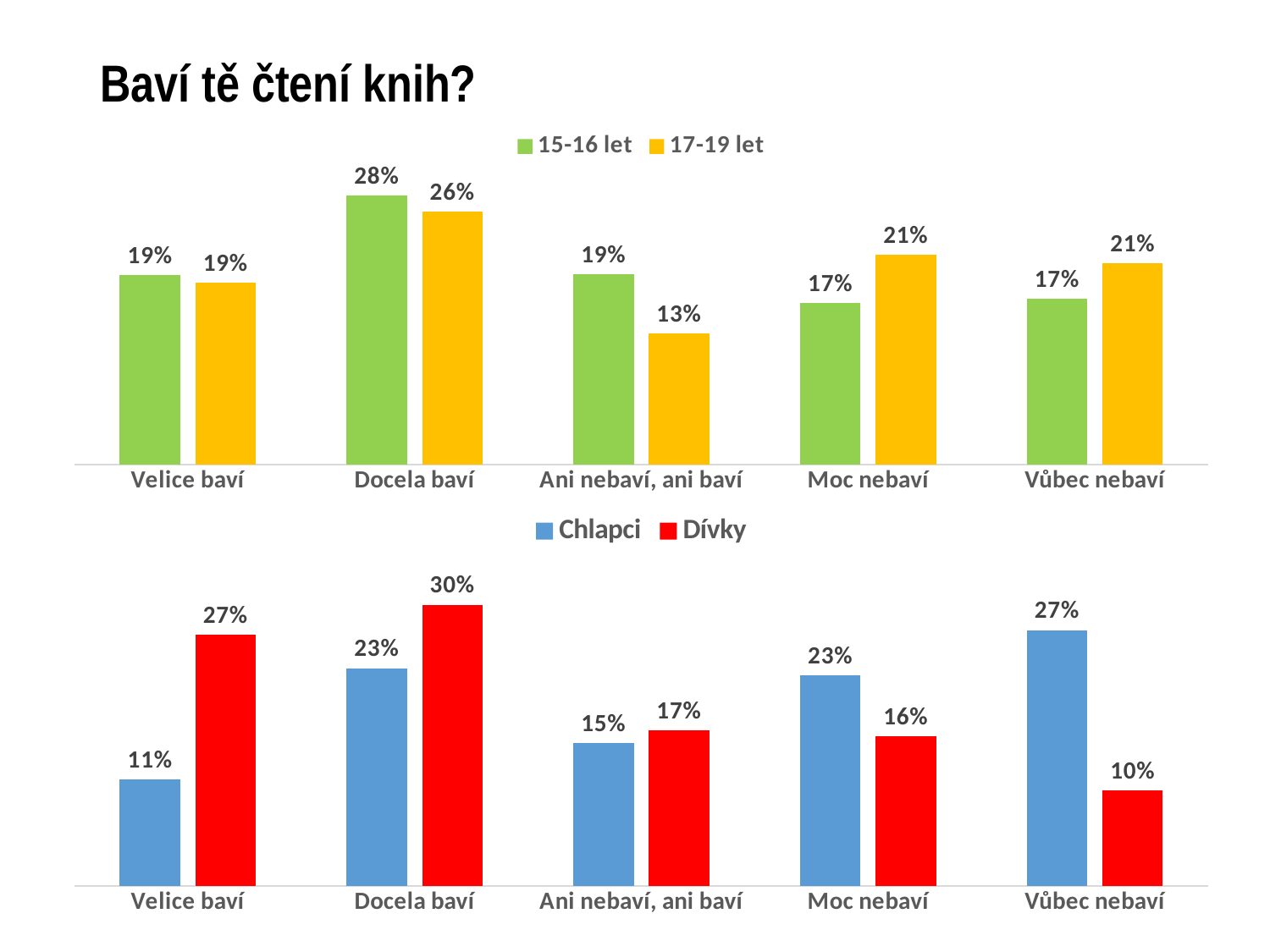
In the top chart (15-16 let / 17-19 let), which is larger for Moc nebaví: 15-16 let or 17-19 let? 17-19 let What kind of chart is the bottom chart (Chlapci / Dívky)? Bar chart In the bottom chart (Chlapci / Dívky), what is the value for Chlapci in the Vůbec nebaví category? 27% In the bottom chart (Chlapci / Dívky), which category has the lowest value for Dívky? Vůbec nebaví In the top chart (15-16 let / 17-19 let), how many series does the legend list? 2 In the top chart (15-16 let / 17-19 let), what is the difference between the 15-16 let and 17-19 let values for Ani nebaví, ani baví? 6% In the bottom chart (Chlapci / Dívky), what is the difference between Dívky and Chlapci for Velice baví? 16% In the bottom chart (Chlapci / Dívky), which is larger for Moc nebaví: Chlapci or Dívky? Chlapci In the top chart (15-16 let / 17-19 let), what is the value for 17-19 let in the Ani nebaví, ani baví category? 13% In the top chart (15-16 let / 17-19 let), what is the value for 15-16 let in the Docela baví category? 28% In the top chart (15-16 let / 17-19 let), which category has the highest value for 17-19 let? Docela baví In the bottom chart (Chlapci / Dívky), how many categories are shown on the x axis? 5